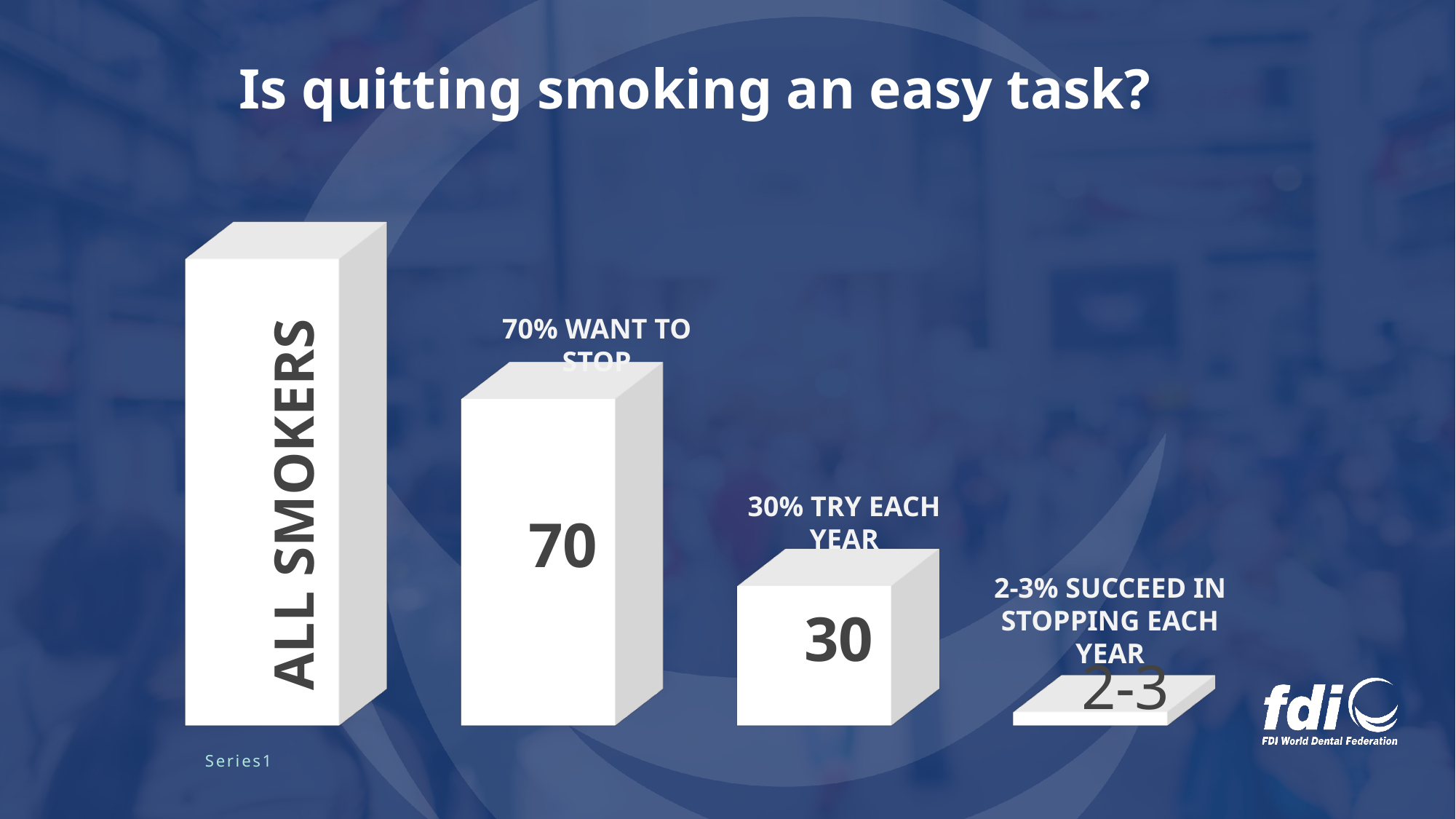
Do the bar heights rise or fall from left to right across the chart? fall Which bar is the tallest in the chart? ALL SMOKERS What value is printed on the bar labelled "2-3% SUCCEED IN STOPPING EACH YEAR"? 2-3 What value is printed on the bar labelled "30% TRY EACH YEAR"? 30 What value is printed on the bar labelled "70% WANT TO STOP"? 70 How many bars are shown in the chart? 4 What kind of chart is shown on the slide? bar chart Which bar is the shortest in the chart? 2-3% SUCCEED IN STOPPING EACH YEAR What is the difference between the value for "70% WANT TO STOP" and the value for "30% TRY EACH YEAR"? 40 What is the title of the slide containing the chart? Is quitting smoking an easy task? Which is larger: the bar for "30% TRY EACH YEAR" or the bar for "2-3% SUCCEED IN STOPPING EACH YEAR"? 30% TRY EACH YEAR What series name is printed below the chart at the bottom left? Series1